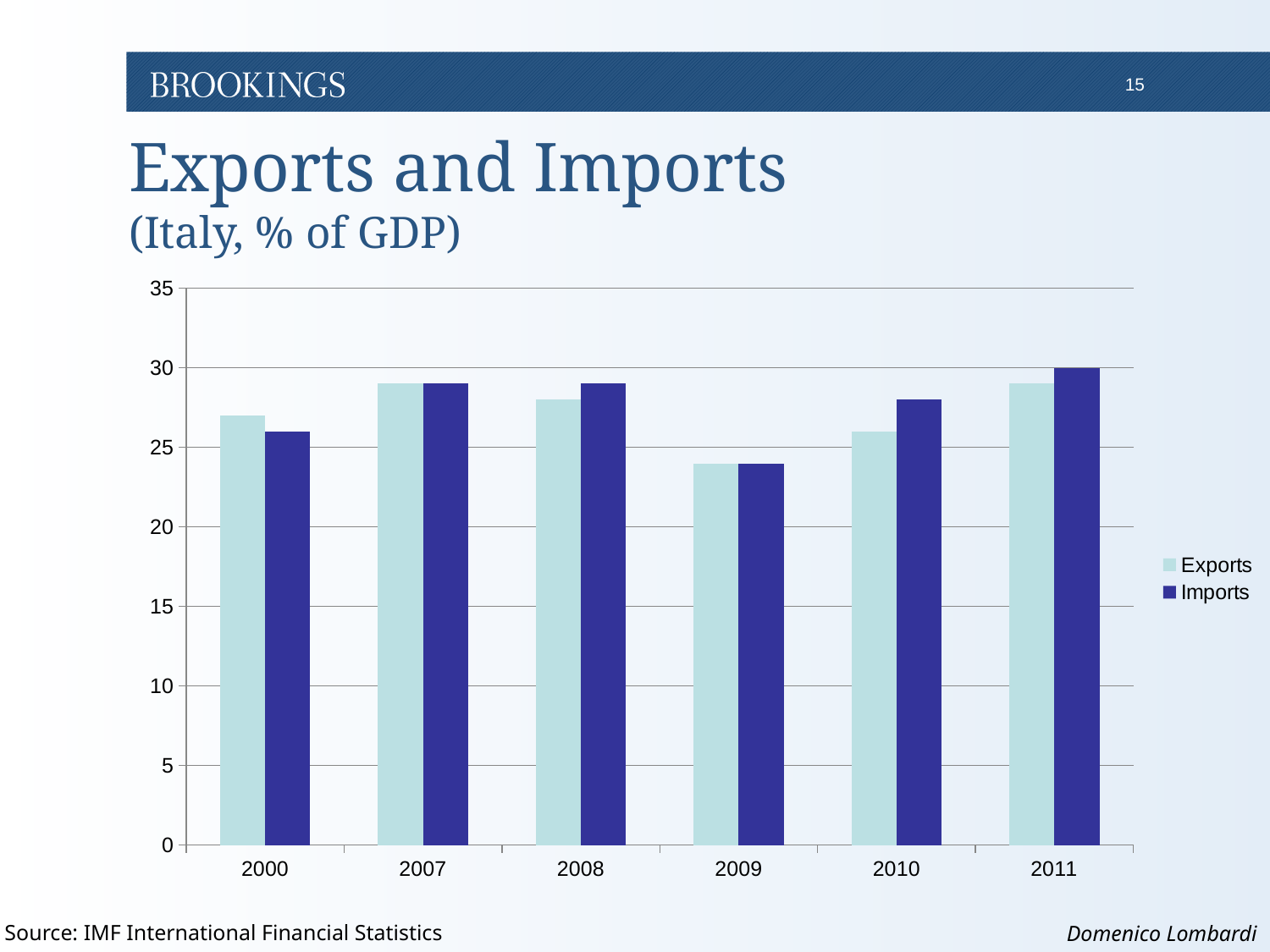
Is the value for Exports in 2000 greater or less than 25? greater How many years are shown on the x axis of the chart? 6 How many series does the legend list? 2 What is the value of Imports in 2011? 30 What are the two series listed in the legend? Exports and Imports Is the value for Imports in 2008 greater or less than 30? less In 2010, which is larger, Exports or Imports? Imports Is the value for Exports in 2009 greater or less than 25? less In which year are Imports lowest? 2009 In which year are Exports lowest? 2009 What kind of chart is shown on the slide? bar chart Do Exports rise or fall from 2007 to 2009? fall